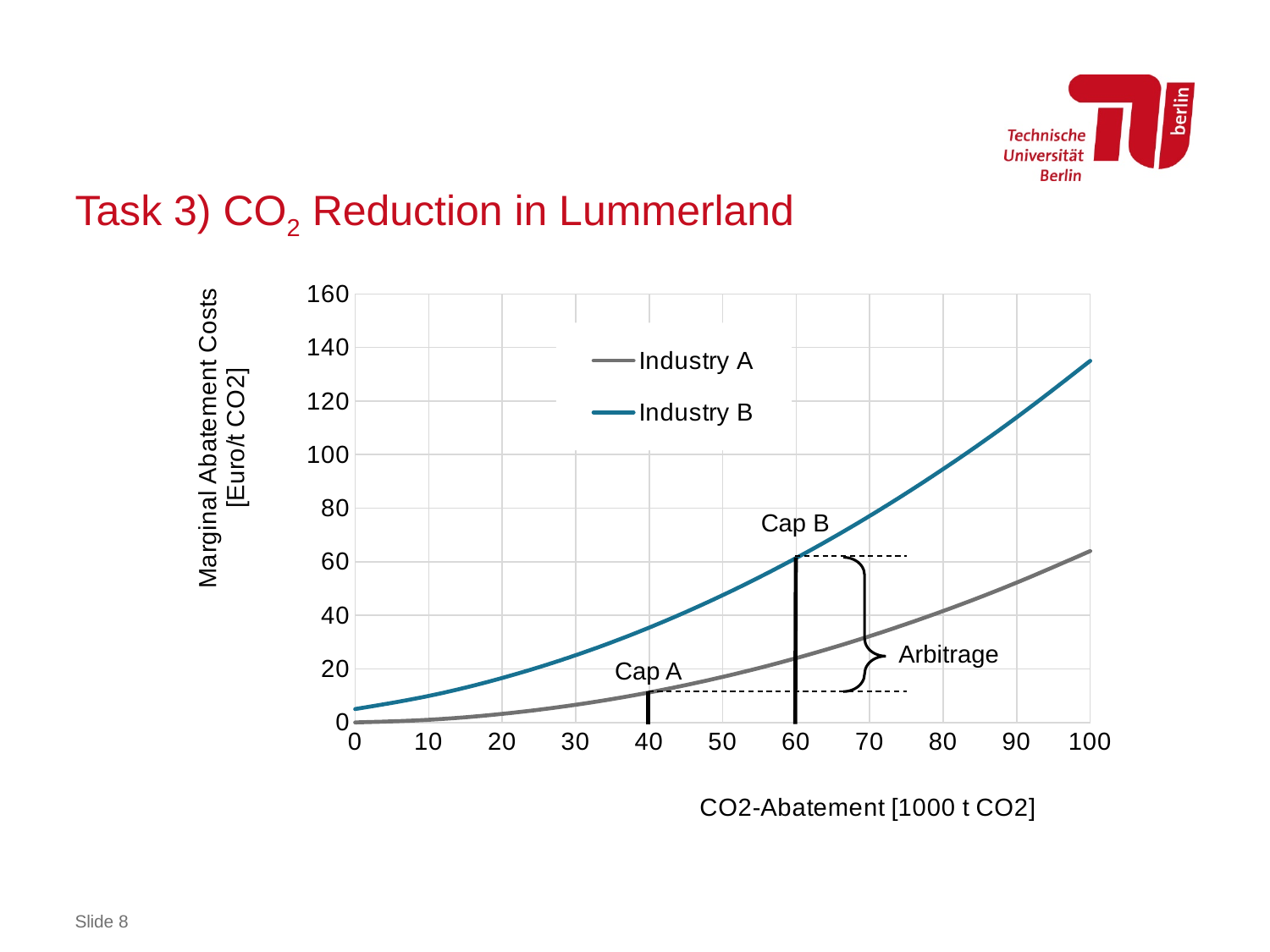
Is the value for Industry B at a CO2 abatement of 60 greater or less than 40? greater At which CO2 abatement value on the x axis is the vertical line labelled Cap A drawn? 40 At a CO2 abatement of 60, which series has the higher marginal abatement cost, Industry A or Industry B? Industry B How many series does the legend list? 2 What is the title of the y axis? Marginal Abatement Costs [Euro/t CO2] Is the value for Industry B at a CO2 abatement of 100 greater or less than 120? greater Which two series are listed in the legend? Industry A and Industry B Is the value for Industry A at a CO2 abatement of 100 greater or less than 80? less What kind of chart is shown on the slide? line chart Do the marginal abatement costs for Industry A rise or fall as CO2 abatement increases along the x axis? rise Do the marginal abatement costs for Industry B rise or fall as CO2 abatement increases along the x axis? rise